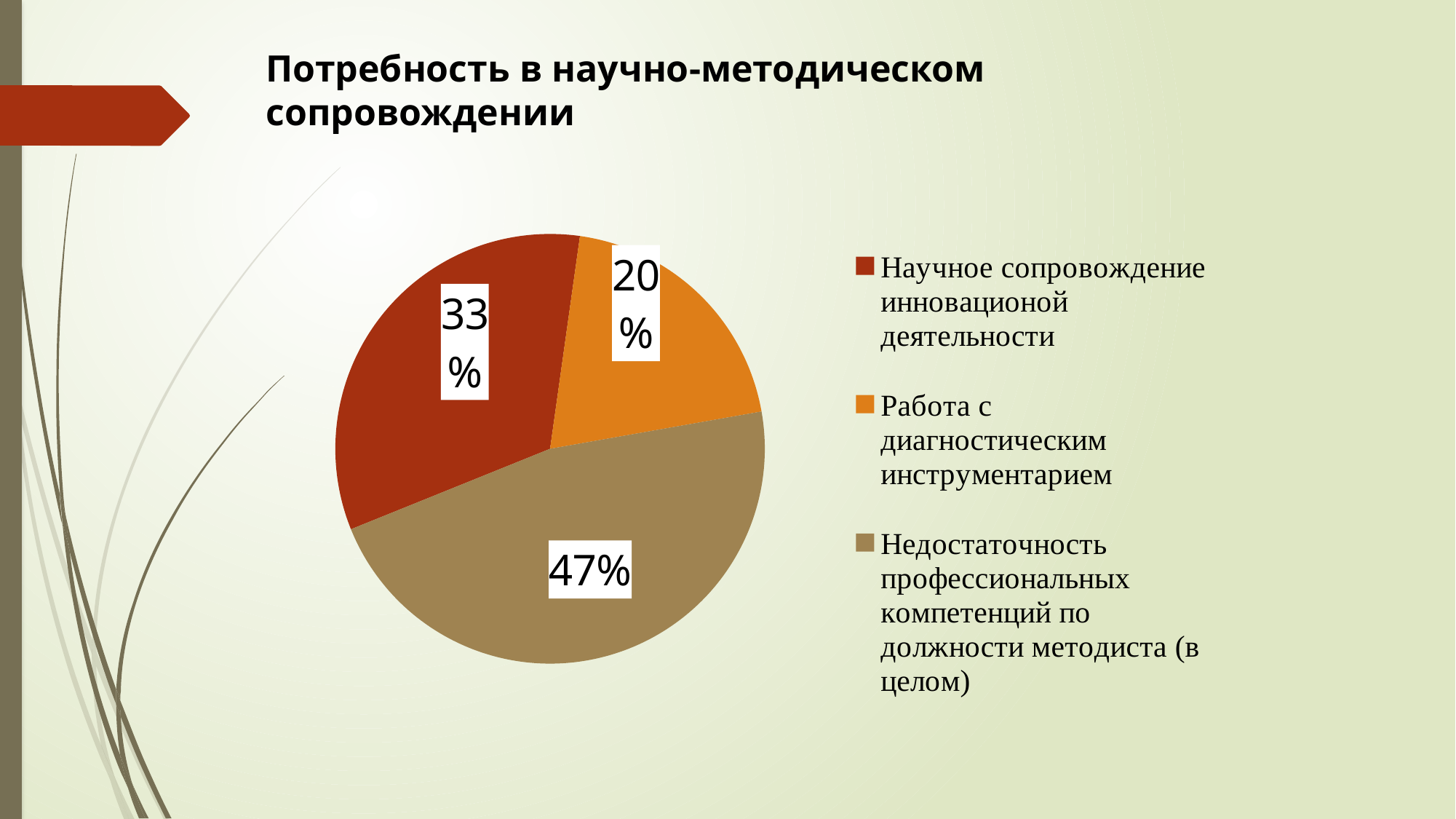
Which is larger: the slice for "Научное сопровождение инновационой деятельности" or the slice for "Работа с диагностическим инструментарием"? Научное сопровождение инновационой деятельности What share of the pie does "Работа с диагностическим инструментарием" have? 20% How many entries does the legend list? 3 What is the difference in percentage points between the largest slice and the smallest slice? 27 What colour is the slice for "Работа с диагностическим инструментарием"? orange Which category has the largest slice of the pie? Недостаточность профессиональных компетенций по должности методиста (в целом) How many slices does the pie chart have? 3 What kind of chart is shown on the slide? pie chart Which category has the smallest slice of the pie? Работа с диагностическим инструментарием What share of the pie does "Научное сопровождение инновационой деятельности" have? 33% What is the difference in percentage points between "Научное сопровождение инновационой деятельности" and "Работа с диагностическим инструментарием"? 13 What share of the pie does "Недостаточность профессиональных компетенций по должности методиста (в целом)" have? 47%